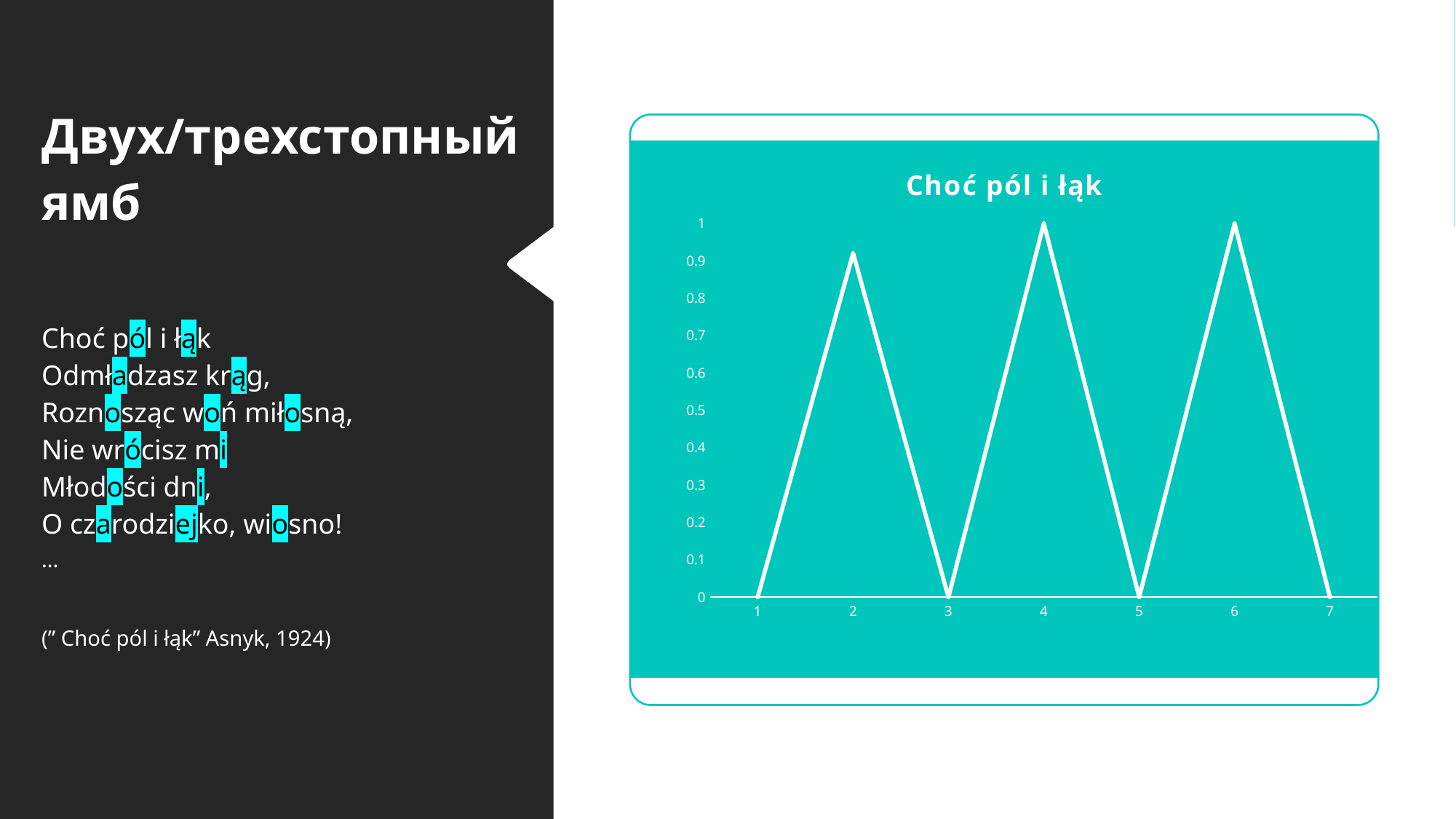
What is the difference between the value at x = 4 and the value at x = 5? 1 What type of chart is shown on the slide? line chart Which is larger, the value at x = 4 or the value at x = 5? x = 4 What is the title of the chart? Choć pól i łąk Is the value at x = 2 greater or less than 0.8? greater How many points are plotted along the x axis of the chart? 7 What is the value at x = 6 in the chart? 1 What is the value at x = 4 in the chart? 1 What is the value at x = 7 in the chart? 0 Which is larger, the value at x = 2 or the value at x = 3? x = 2 What is the value at x = 1 in the chart? 0 Is the value at x = 2 greater or less than 0.5? greater